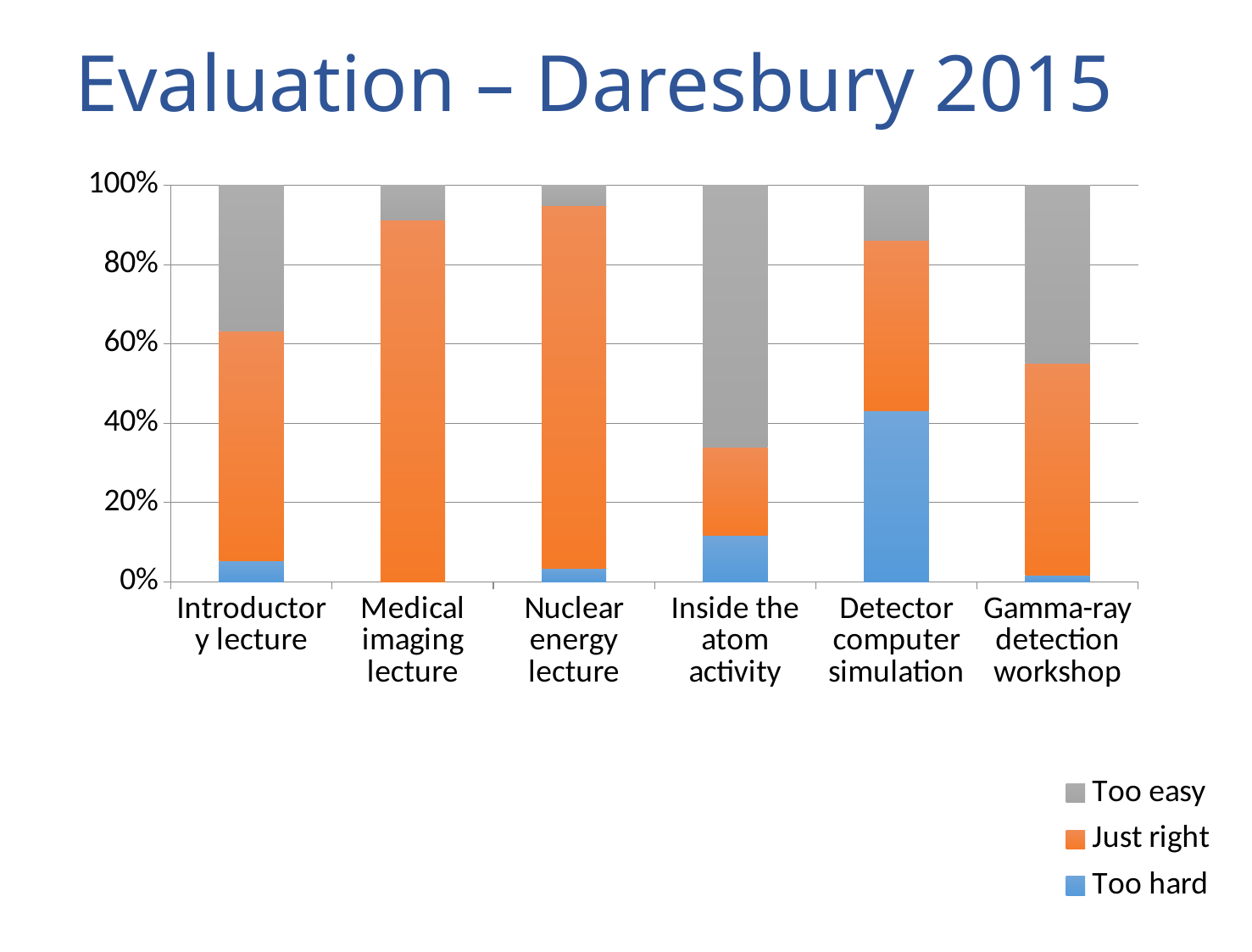
Which category has the smallest 'Just right' share? Inside the atom activity Which series is shown in grey in the legend? Too easy How many categories are shown along the x axis? 6 Is the 'Too hard' value for Detector computer simulation greater or less than 20%? greater Which category has the largest 'Too hard' share? Detector computer simulation What is the total of the stacked bar for Introductory lecture? 100% Which is larger, the 'Too hard' share for Inside the atom activity or for Introductory lecture? Inside the atom activity Is the 'Just right' value for Medical imaging lecture greater or less than 80%? greater Is the 'Too easy' value for Inside the atom activity greater or less than 60%? greater Which category has the largest 'Too easy' share? Inside the atom activity How many series does the legend list? 3 What kind of chart is shown on the slide? Stacked bar chart